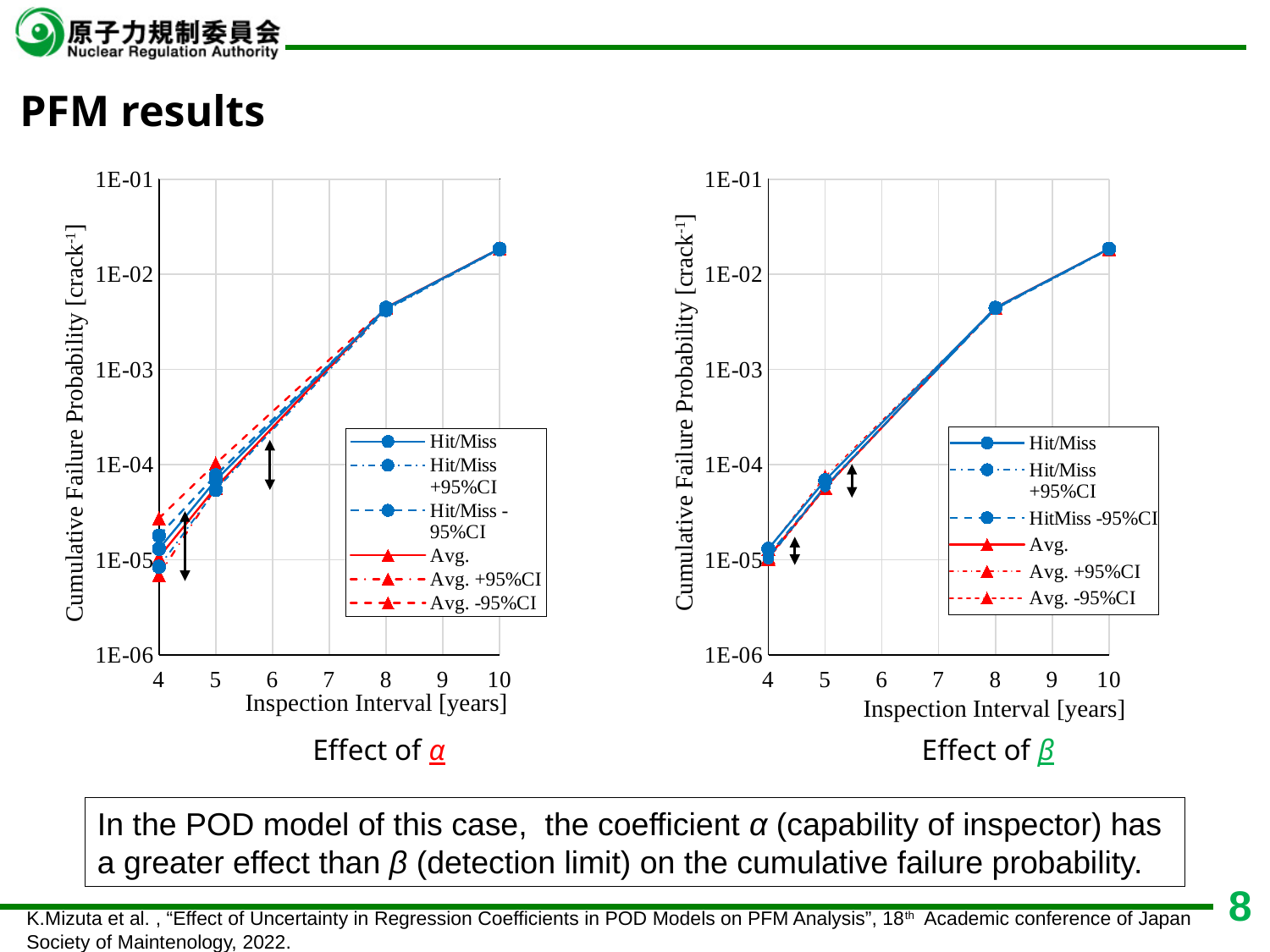
What is the x-axis label of the 'Effect of β' chart? Inspection Interval [years] In the 'Effect of α' chart, at which plotted inspection interval is the cumulative failure probability highest? 10 years In the 'Effect of α' chart, how many inspection-interval points are plotted for the Hit/Miss series? 4 In the 'Effect of β' chart, is the Avg. value at an inspection interval of 8 years greater or less than 1E-03? greater In the 'Effect of α' chart, does the cumulative failure probability rise or fall as the inspection interval increases? rise In the 'Effect of β' chart, is the Hit/Miss value at an inspection interval of 10 years greater or less than 1E-02? greater How many series does the legend of the 'Effect of β' chart on the right list? 6 What kind of chart is the 'Effect of α' chart on the left? line chart In the 'Effect of α' chart, is the Avg. value at an inspection interval of 4 years greater or less than 1E-04? less In the 'Effect of α' chart, what colour are the Avg. series lines? red In the 'Effect of α' chart, which inspection interval gives the highest cumulative failure probability for the Hit/Miss series, 4 years or 10 years? 10 years In the 'Effect of β' chart, at which plotted inspection interval is the cumulative failure probability lowest? 4 years